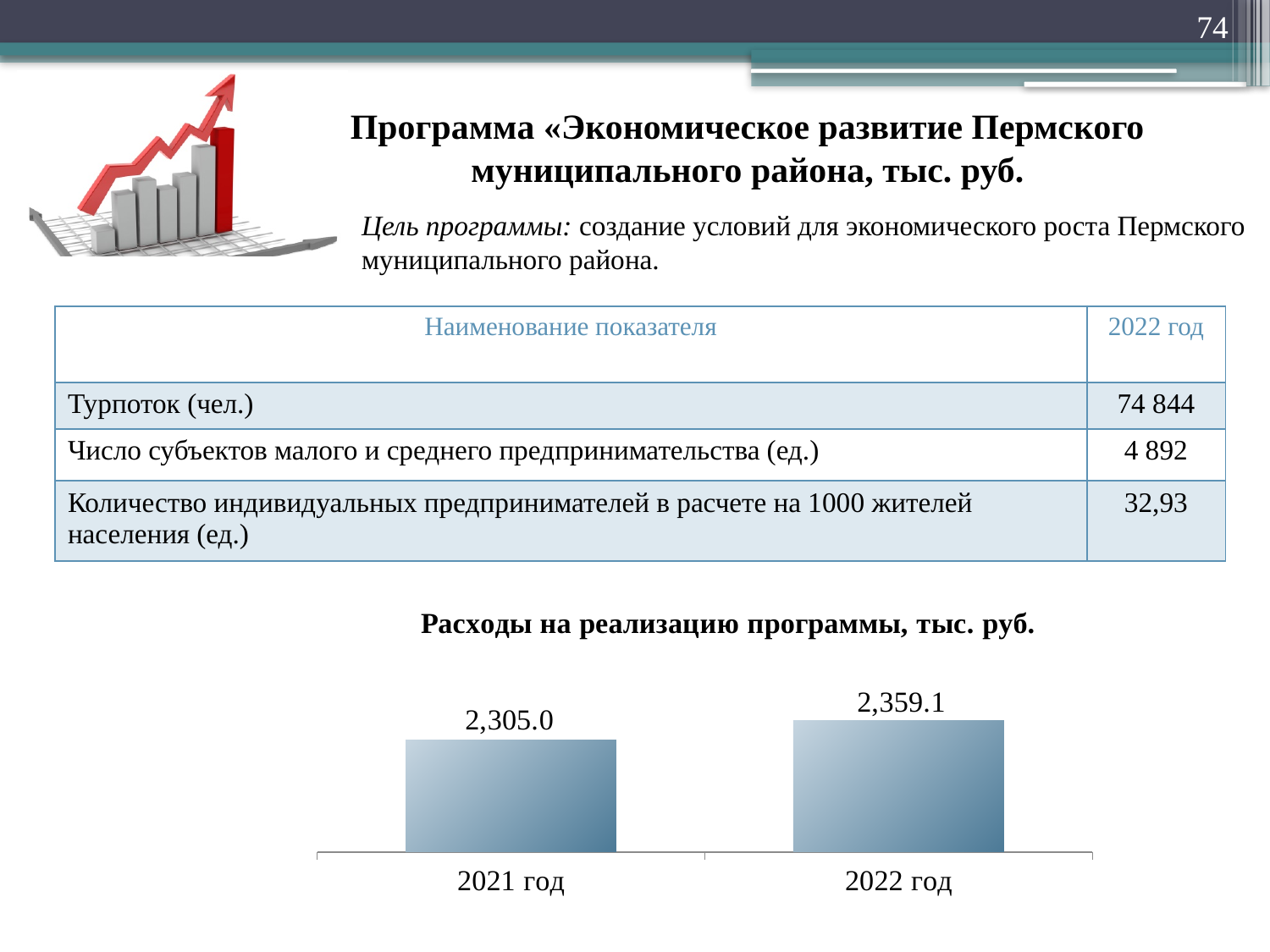
Which year has the highest value in the chart? 2022 год What is the value for 2021 год in the chart? 2,305.0 How many categories are shown in the chart? 2 What is the difference between the values for 2022 год and 2021 год? 54.1 Which is larger, the value for 2021 год or the value for 2022 год? 2022 год What kind of chart is shown on the slide? bar chart Which year has the lowest value in the chart? 2021 год What is the value for 2022 год in the chart? 2,359.1 Do the values rise or fall from 2021 год to 2022 год? rise What is the title of the chart? Расходы на реализацию программы, тыс. руб.